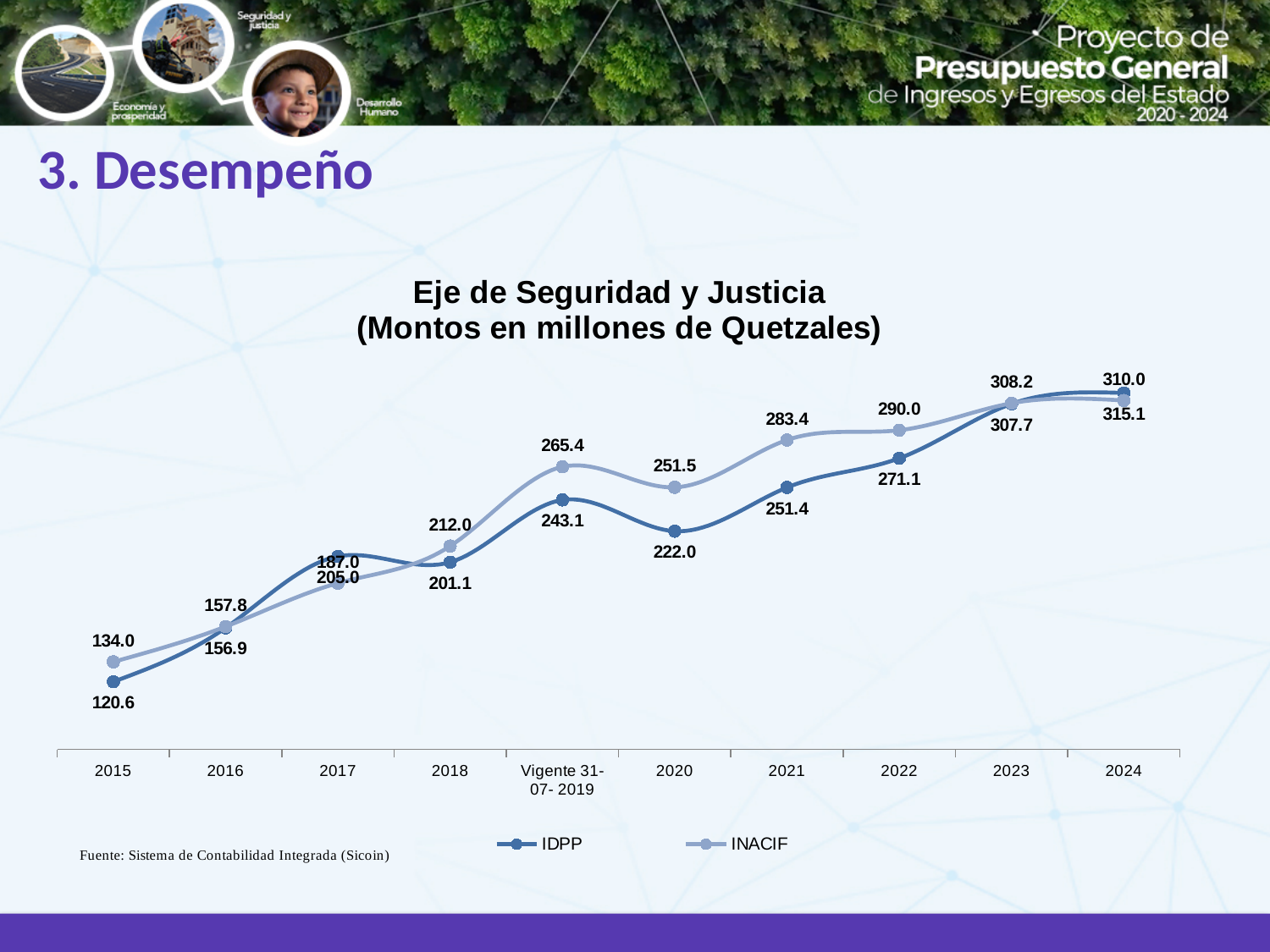
In which year is the INACIF value lowest? 2015 What is the value for IDPP in 2020? 222.0 What is the value for INACIF at 'Vigente 31-07-2019'? 265.4 How many series does the legend list? 2 In which year does IDPP reach its highest value? 2024 What is the value for INACIF in 2021? 283.4 What kind of chart is shown on the slide? Line chart What is the difference between the INACIF and IDPP values in 2015? 13.4 What is the title of the chart? Eje de Seguridad y Justicia (Montos en millones de Quetzales) Does the IDPP series generally rise or fall from 2015 to 2024? Rise Which series has the larger value in 2018, IDPP or INACIF? INACIF How many points are plotted along the x axis for each series? 10